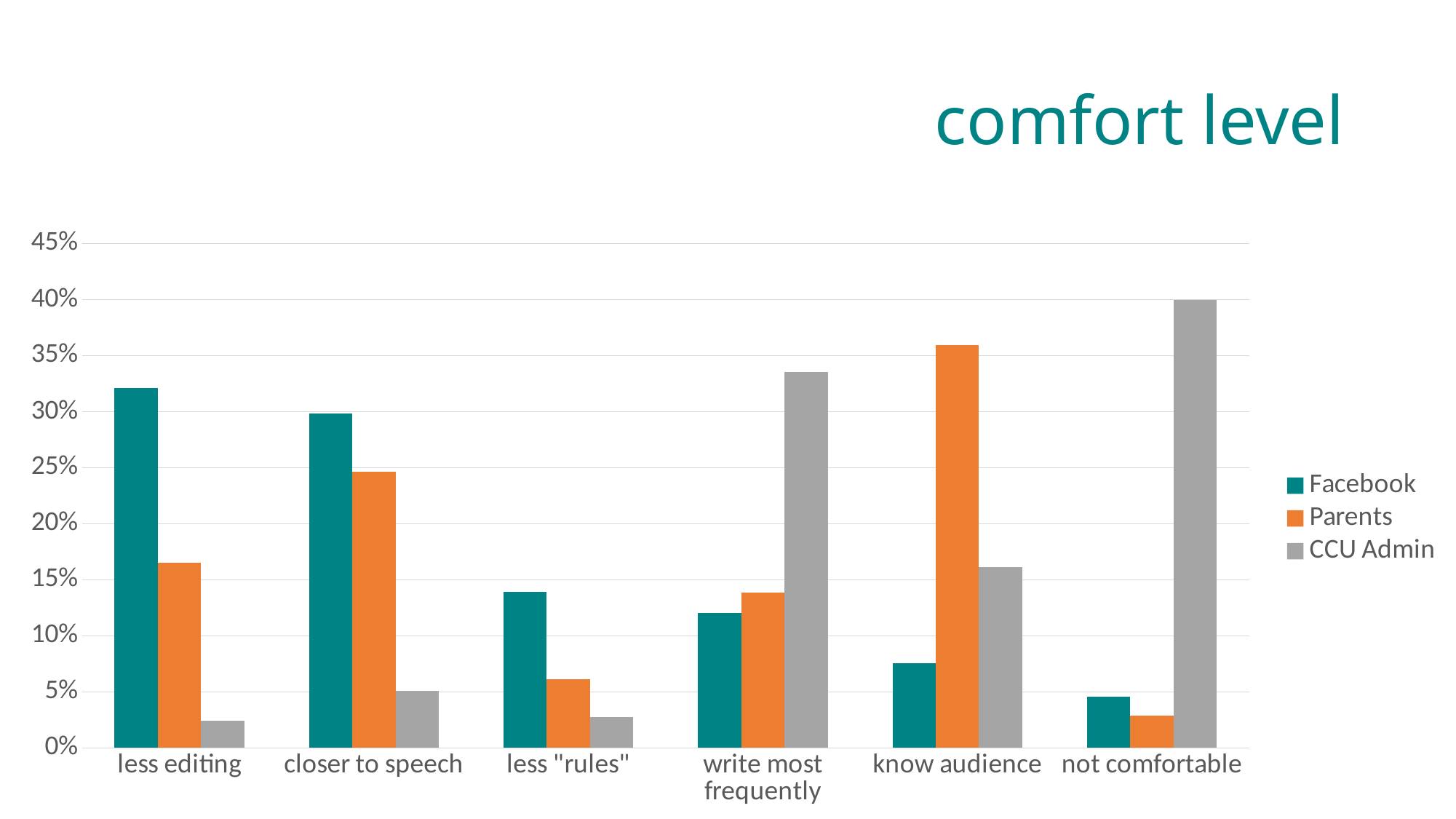
Which category has the highest Parents value? know audience Do the Facebook values rise or fall moving left to right along the x axis? fall What is the title of the chart? comfort level How many series does the legend list? 3 Which category has the lowest Facebook value? not comfortable How many categories are shown on the x axis? 6 Which category has the highest CCU Admin value? not comfortable For "less editing", which is larger: the Facebook value or the Parents value? Facebook What kind of chart is shown on the slide? bar chart Is the Facebook value for "less editing" greater or less than 30%? greater Is the CCU Admin value for "write most frequently" greater or less than 30%? greater Which category has the highest Facebook value? less editing